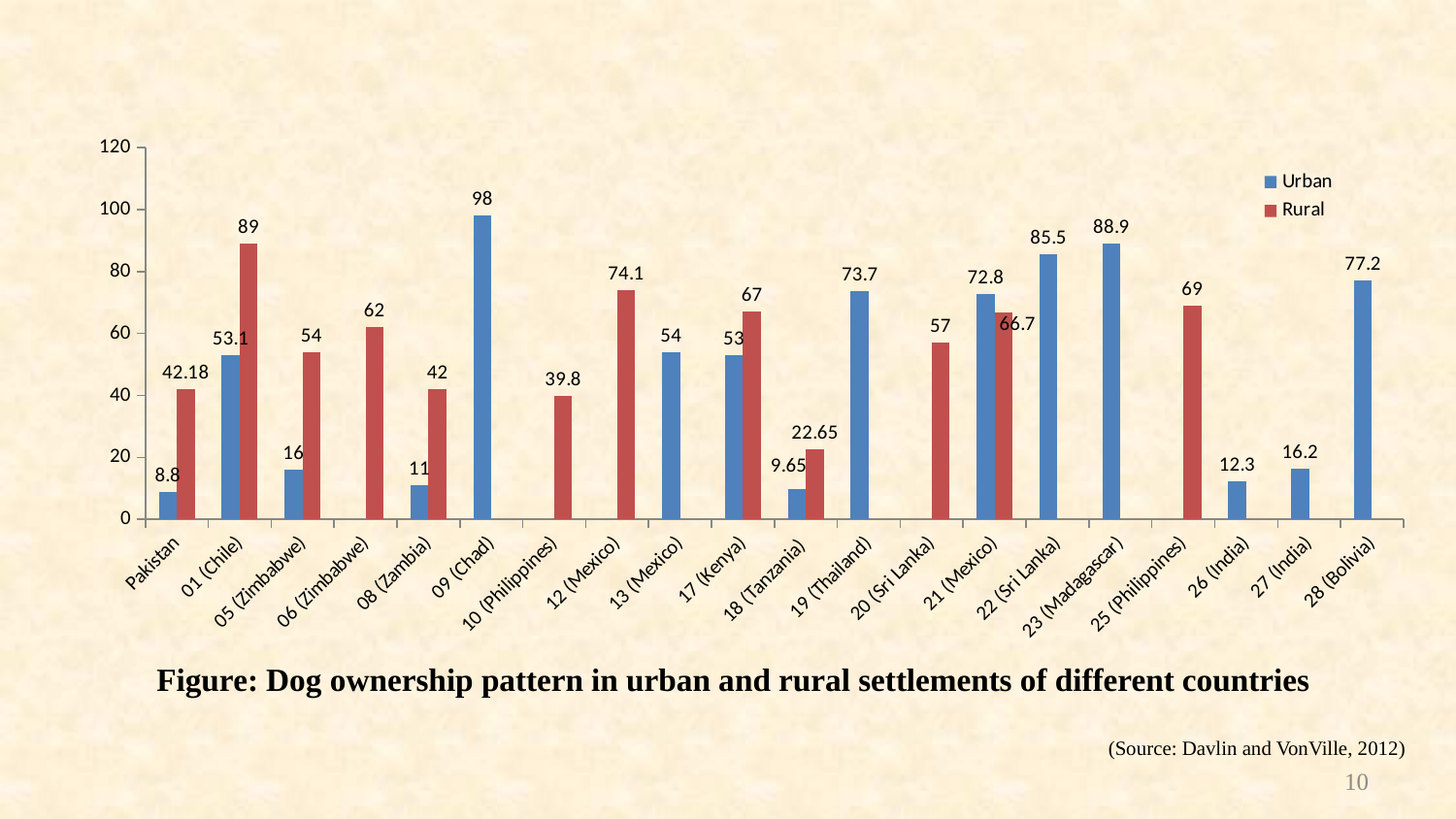
Which category has the lowest Urban value? Pakistan What is the Rural value for Pakistan? 42.18 How many categories are shown on the x axis? 20 For 21 (Mexico), which is larger, the Urban value or the Rural value? Urban Which category has the highest Rural value? 01 (Chile) What colour represents the Rural series? Red What is the Urban value for 09 (Chad)? 98 Which category has the highest Urban value? 09 (Chad) What is the Rural value for 18 (Tanzania)? 22.65 What kind of chart is shown on the slide? Bar chart How many series does the legend list? 2 What is the difference between the Rural and Urban values for 01 (Chile)? 35.9